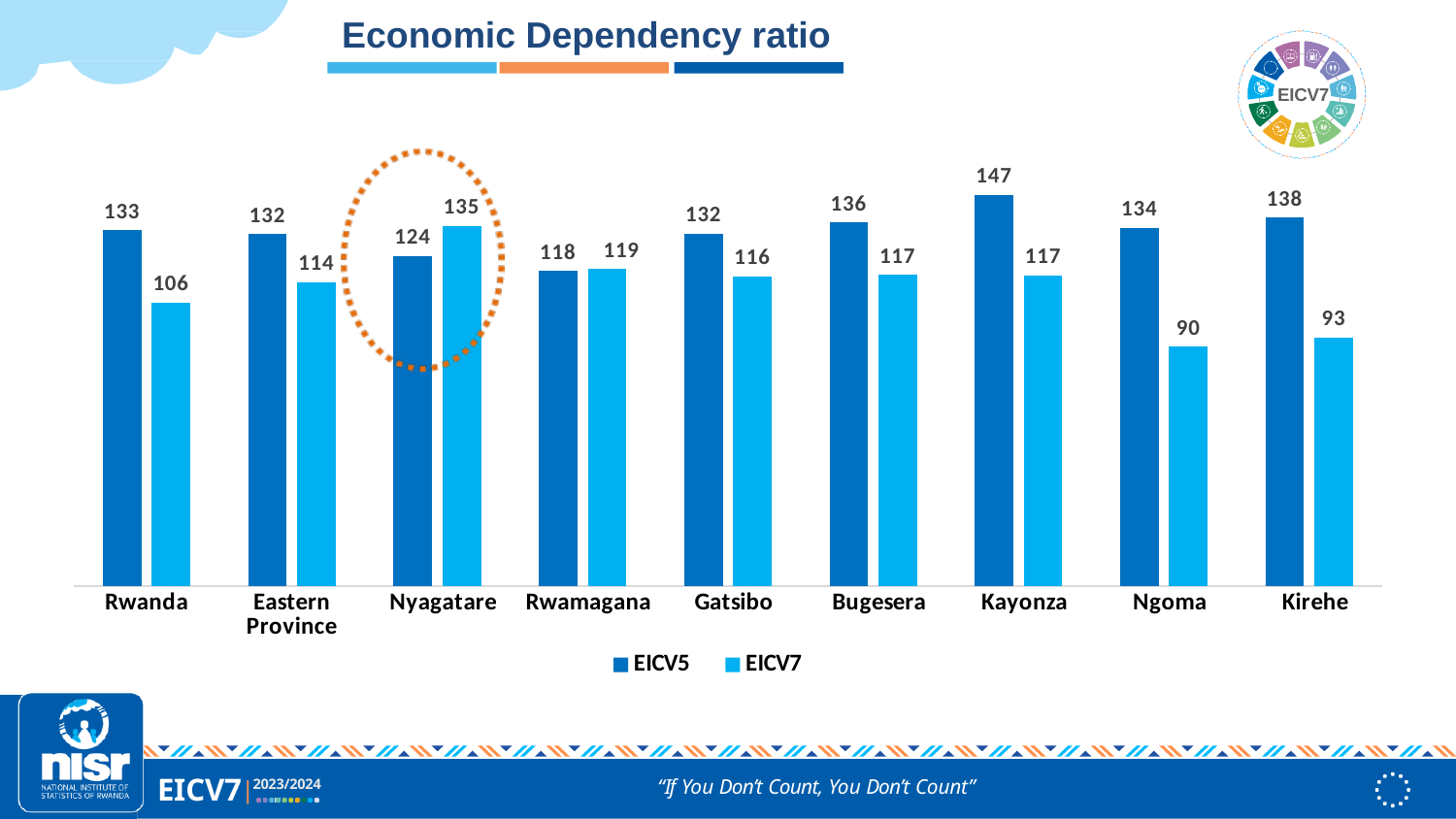
What is the EICV7 value for Nyagatare? 135 What is the EICV5 economic dependency ratio for Kayonza? 147 What type of chart is shown on the slide? Bar chart How many series does the legend list? 2 What is the difference between the EICV5 and EICV7 values for Ngoma? 44 What is the EICV7 economic dependency ratio for Rwanda? 106 Which district has the highest EICV5 economic dependency ratio? Kayonza What is the title of the chart? Economic Dependency ratio Which category is highlighted with a dotted circle on the chart? Nyagatare How many categories are shown on the x axis of the chart? 9 Which is larger for Nyagatare, the EICV5 value or the EICV7 value? EICV7 Which category has the lowest EICV7 economic dependency ratio? Ngoma